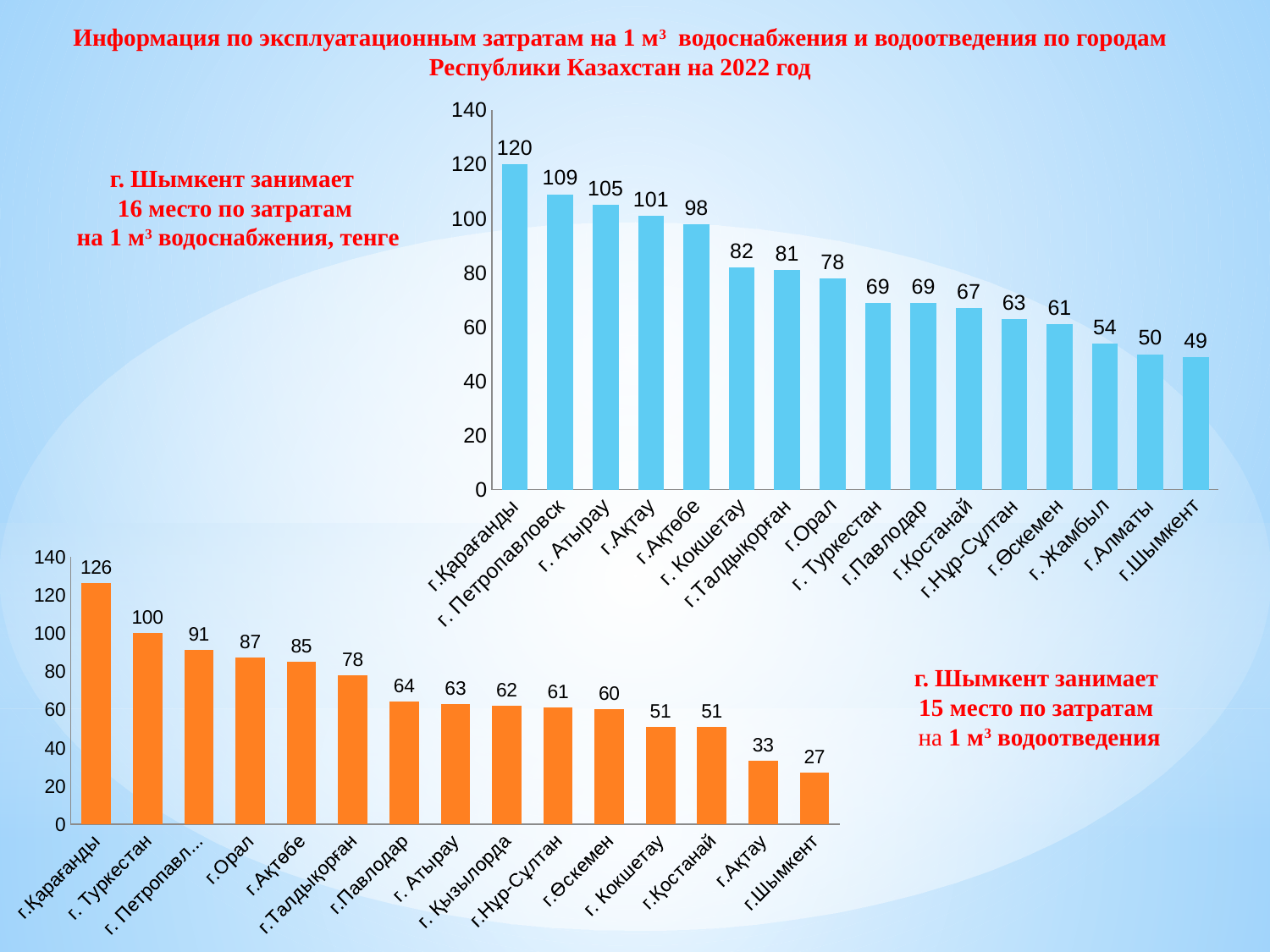
On the upper-right blue bar chart, what is the difference between г. Петропавловск and г. Атырау? 4 On the lower-left orange bar chart, which is larger, г.Ақтау or г.Шымкент? г.Ақтау On the upper-right blue bar chart, do the values rise or fall from left to right? fall On the upper-right blue bar chart, what is the value for г.Қарағанды? 120 On the upper-right blue bar chart, how many cities are shown? 16 On the lower-left orange bar chart, which city has the highest value? г.Қарағанды On the upper-right blue bar chart, what is the value for г.Шымкент? 49 What type of chart is the lower-left chart? bar chart On the lower-left orange bar chart, how many cities are shown? 15 On the lower-left orange bar chart, what is the difference between г.Қарағанды and г.Шымкент? 99 On the lower-left orange bar chart, what is the value for г. Туркестан? 100 On the upper-right blue bar chart, which city has the lowest value? г.Шымкент